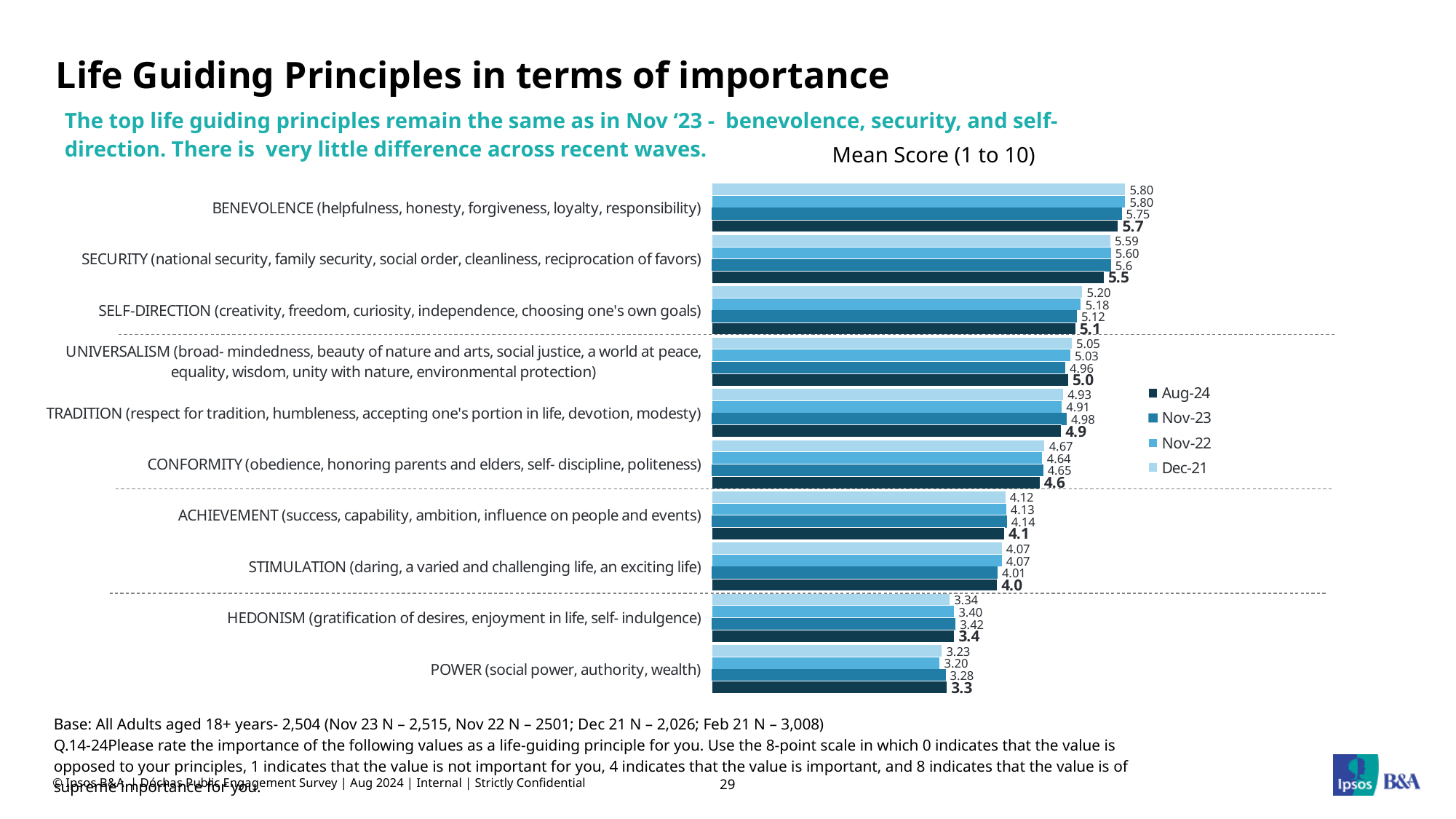
Which principle has the highest Aug-24 mean score? BENEVOLENCE What is the difference between the Aug-24 mean scores for BENEVOLENCE and POWER? 2.4 How many series does the legend list? 4 Which principle has the lowest Aug-24 mean score? POWER What is the Aug-24 mean score for POWER? 3.3 What is the Aug-24 mean score for SECURITY? 5.5 Which has a higher Aug-24 mean score, CONFORMITY or ACHIEVEMENT? CONFORMITY What is the Aug-24 mean score for BENEVOLENCE? 5.7 How many life guiding principles are plotted on the chart? 10 What is the title shown above the chart? Mean Score (1 to 10) What type of chart is shown on the slide? bar chart What is the Dec-21 mean score for HEDONISM? 3.34